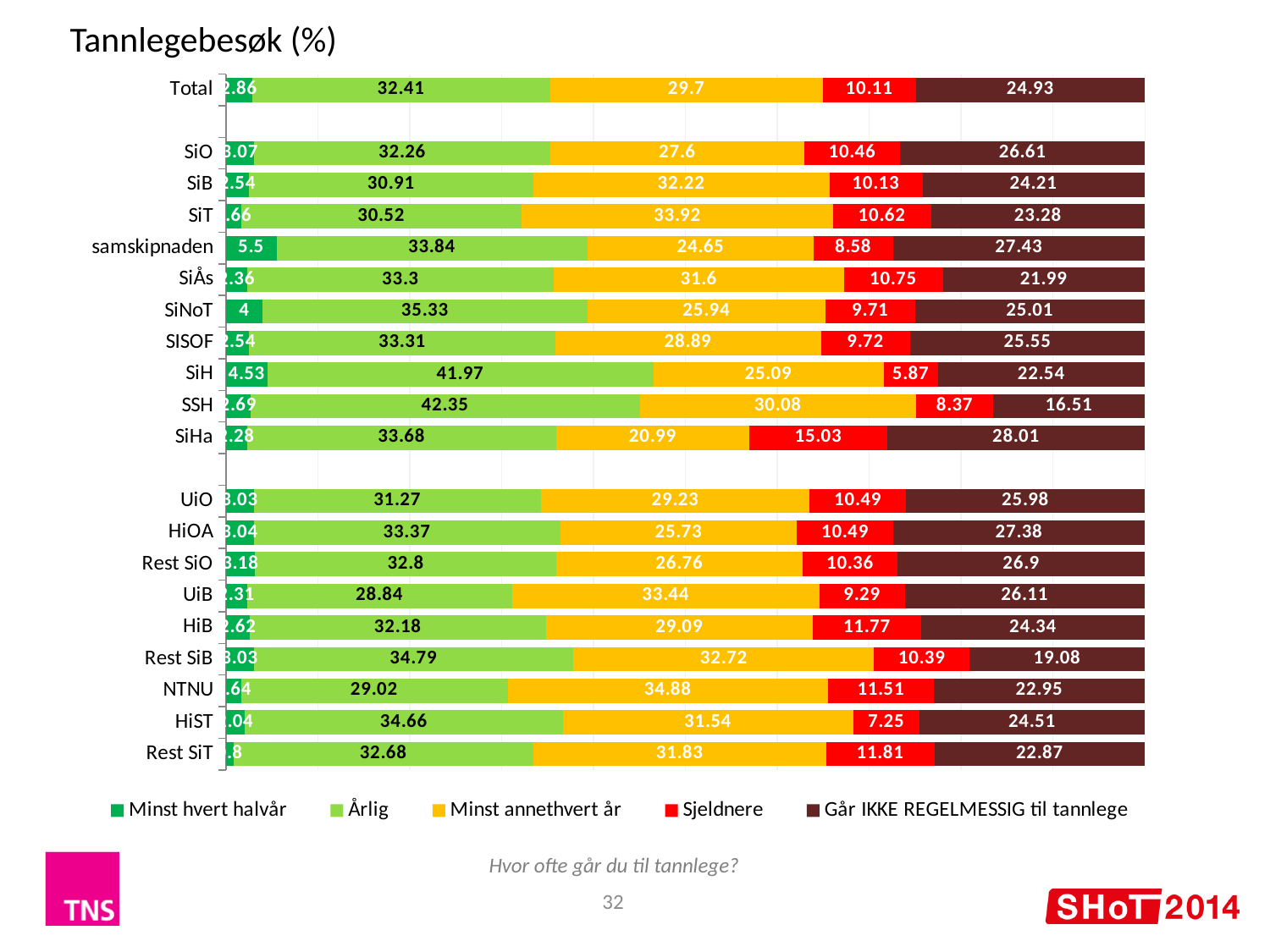
What is the difference between the 'Sjeldnere' value for SiHa and for Total? 4.92 Which category has the lowest value for 'Sjeldnere'? SiH What is the value of 'Minst annethvert år' for SiHa? 20.99 Which category has the highest value for 'Årlig'? SSH How many categories are plotted on the chart? 20 Which has the larger 'Minst annethvert år' value, NTNU or SiT? NTNU What is the value of 'Årlig' for SSH? 42.35 What kind of chart is shown on the slide? bar chart How many series does the legend list? 5 Which category has the highest value for 'Sjeldnere'? SiHa What is the value of 'Minst hvert halvår' for samskipnaden? 5.5 What is the value of 'Går IKKE REGELMESSIG til tannlege' for SiHa? 28.01